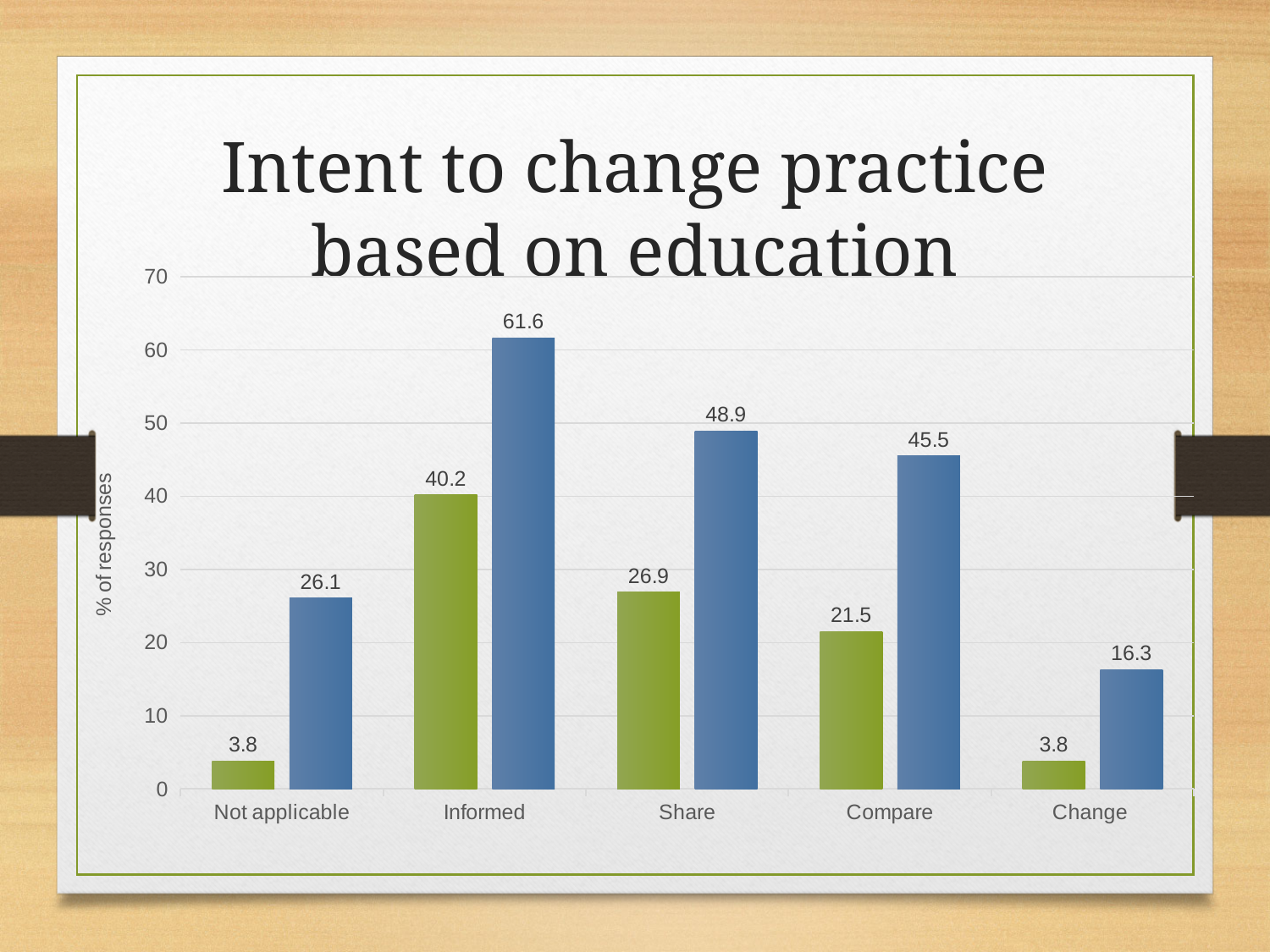
What is the difference between the blue and green bars for Compare? 24 Which category has the highest blue bar? Informed Which category has the lowest blue bar? Change What is the label of the vertical axis? % of responses Is the blue bar for Share greater or less than 40? greater What is the value of the blue bar for Change? 16.3 Which is larger, the green bar for Informed or the blue bar for Not applicable? Green bar for Informed What is the difference between the blue bars for Informed and Share? 12.7 What kind of chart is shown on the slide? Bar chart How many categories are shown on the x axis? 5 What is the value of the green bar for Share? 26.9 What is the value of the blue bar for Informed? 61.6